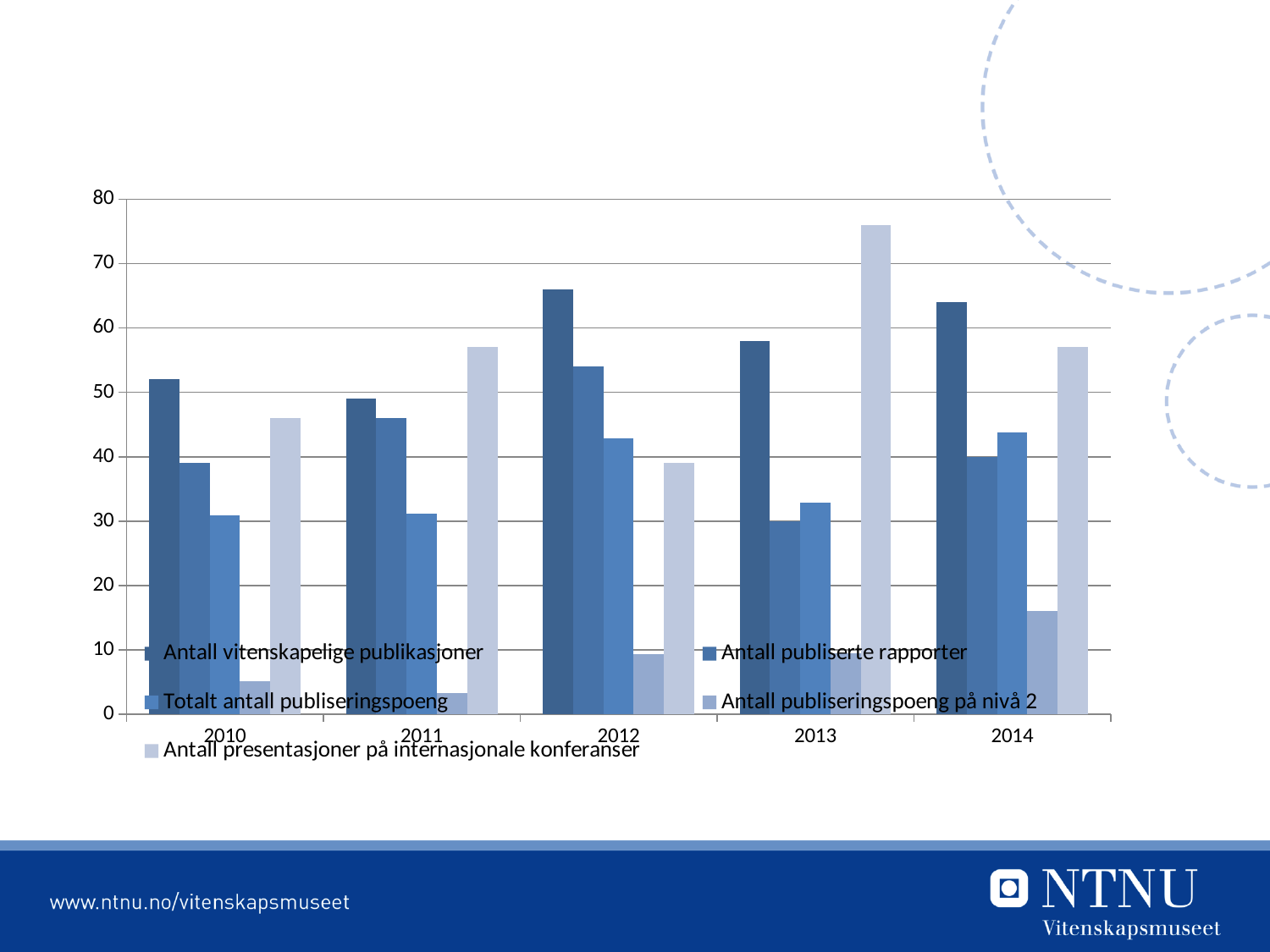
What kind of chart is shown on the slide? bar chart Which year has the highest value for Antall publiseringspoeng på nivå 2? 2014 Is the value for Antall presentasjoner på internasjonale konferanser in 2013 greater or less than 70? greater Is the value for Antall publiseringspoeng på nivå 2 in 2014 greater or less than 20? less In 2010, which is larger: Antall publiserte rapporter or Totalt antall publiseringspoeng? Antall publiserte rapporter Which year has the lowest value for Antall publiserte rapporter? 2013 In 2013, which is larger: Antall vitenskapelige publikasjoner or Antall presentasjoner på internasjonale konferanser? Antall presentasjoner på internasjonale konferanser How many years are shown on the x axis? 5 Which year has the highest value for Antall presentasjoner på internasjonale konferanser? 2013 How many series does the legend list? 5 Is the value for Antall vitenskapelige publikasjoner in 2012 greater or less than 60? greater Which series is drawn in the lightest shade of blue? Antall presentasjoner på internasjonale konferanser